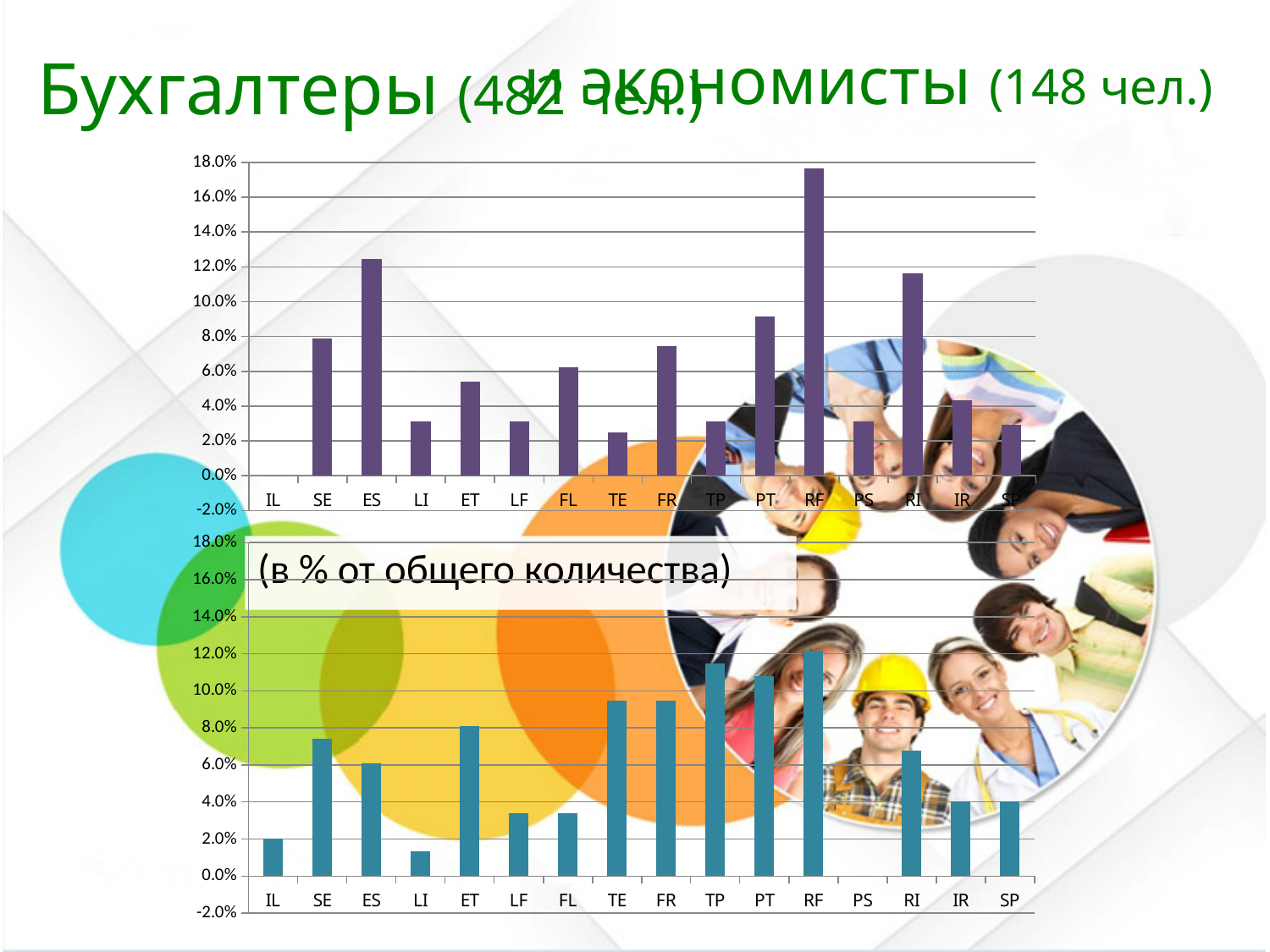
In the top chart, is the value for TE greater or less than 4.0%? less In the top chart, is the value for ES greater or less than 10.0%? greater In the top chart, which category has the highest value? RF In the bottom chart, is the value for IL greater or less than 4.0%? less How many categories are shown on the x axis of the bottom chart? 16 In the bottom chart, which category has the highest value? RF In the bottom chart, which is larger, the value for TE or the value for ES? TE What colour are the bars in the bottom chart? teal blue In the top chart, which is larger, the value for ES or the value for SE? ES What kind of chart is the top chart on the slide? bar chart